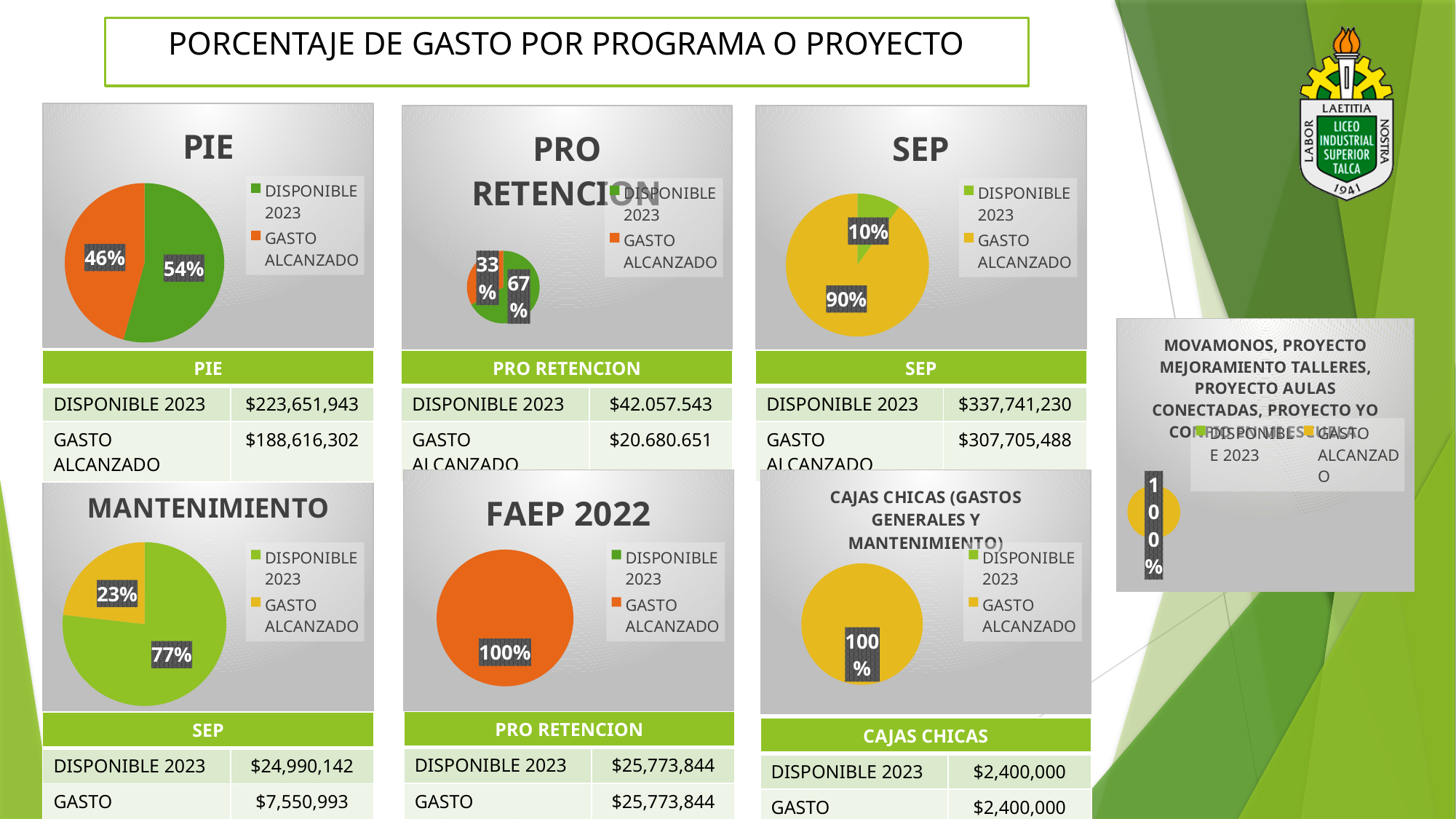
In the SEP chart, what share of the pie is GASTO ALCANZADO? 90% In the MANTENIMIENTO chart, what percentage is shown for DISPONIBLE 2023? 77% In the PIE chart, what share of the pie is GASTO ALCANZADO? 46% In the SEP chart, which slice is larger, DISPONIBLE 2023 or GASTO ALCANZADO? GASTO ALCANZADO In the MANTENIMIENTO chart, what is the difference between the DISPONIBLE 2023 and GASTO ALCANZADO percentages? 54% In the PIE chart, what share of the pie is DISPONIBLE 2023? 54% What kind of chart is the CAJAS CHICAS (GASTOS GENERALES Y MANTENIMIENTO) chart? Pie chart In the FAEP 2022 chart, what percentage is shown for GASTO ALCANZADO? 100% In the PRO RETENCION chart, what percentage is shown for GASTO ALCANZADO? 33% In the SEP chart, what colour is the GASTO ALCANZADO slice? Yellow How many entries does the legend of the PIE chart list? 2 In the PRO RETENCION chart, what percentage is shown for DISPONIBLE 2023? 67%